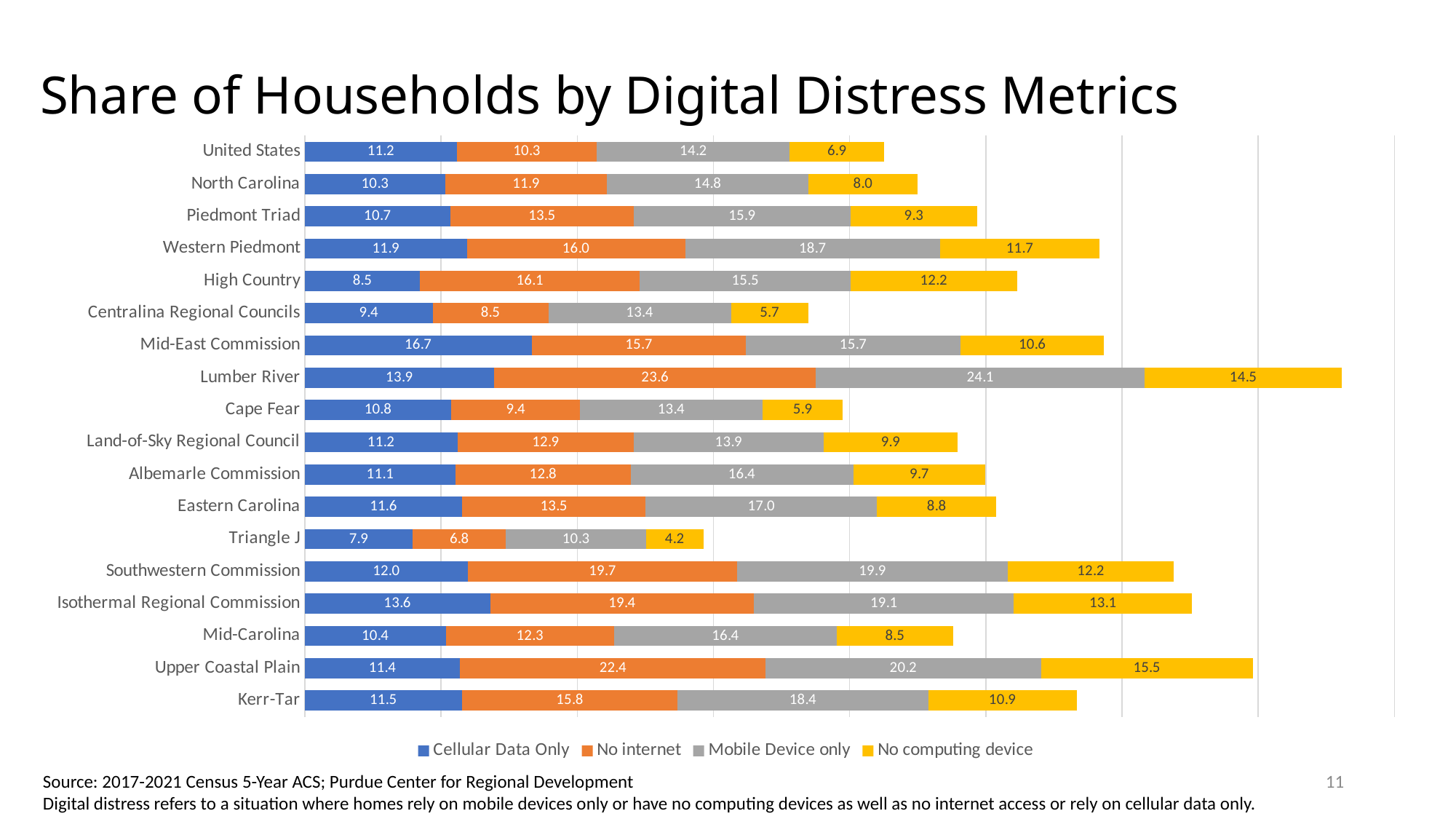
What is the "No computing device" value for High Country? 12.2 What is the difference between the "No internet" values for Western Piedmont and North Carolina? 4.1 Which category has the highest "No computing device" value? Upper Coastal Plain What is the total of the stacked bar for Triangle J? 29.2 Which category has the highest "No internet" value? Lumber River Which category has the lowest "Cellular Data Only" value? Triangle J What is the "No internet" value for Lumber River? 23.6 How many categories are shown on the chart? 18 How many series does the legend list? 4 What kind of chart is shown on the slide? Stacked bar chart Which has a larger "Cellular Data Only" value, Mid-East Commission or Lumber River? Mid-East Commission What is the "Cellular Data Only" value for Mid-East Commission? 16.7